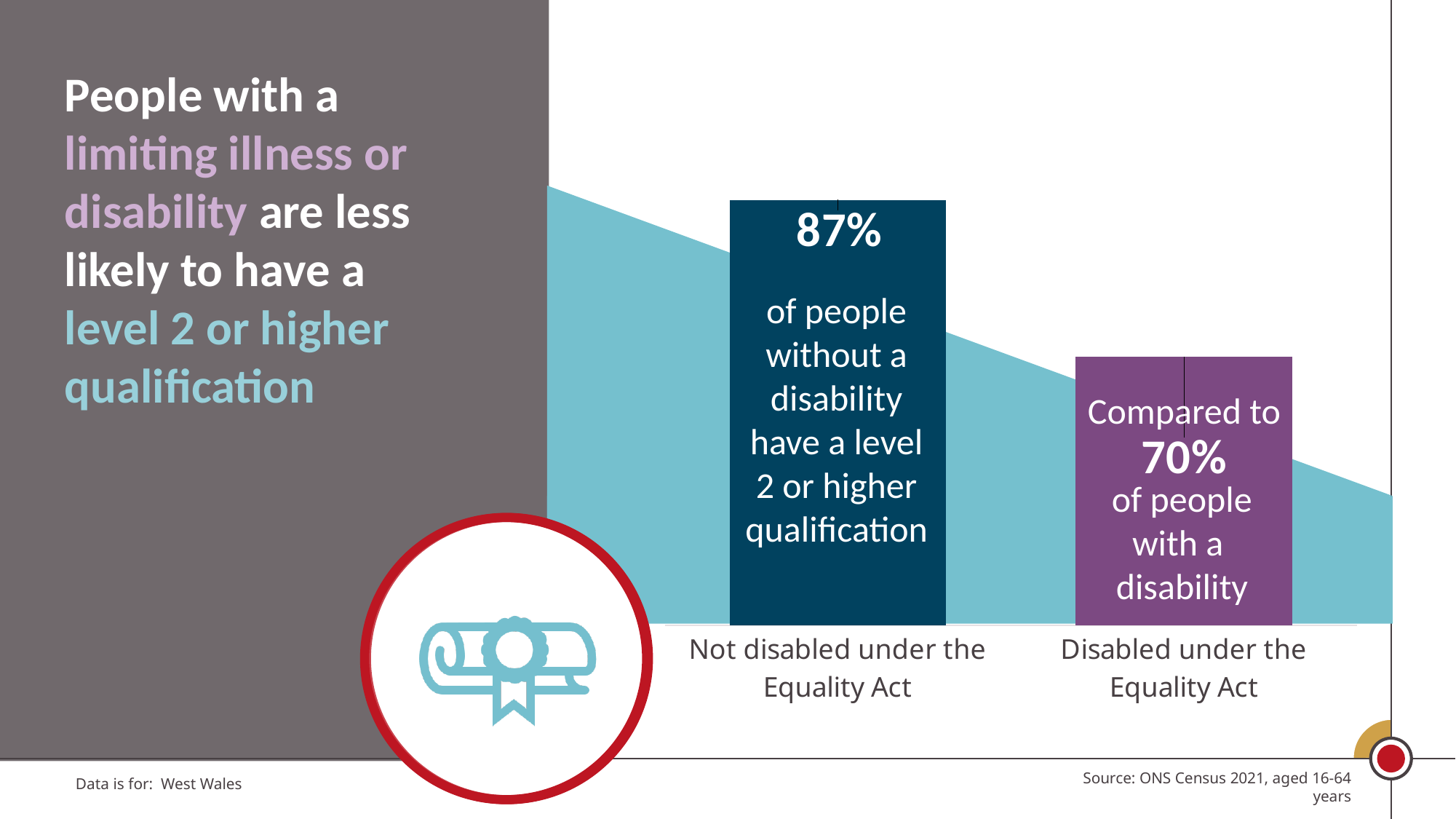
Do the values rise or fall from left to right across the chart? fall Which category has the higher value? Not disabled under the Equality Act Is the value for people not disabled under the Equality Act larger or smaller than the value for people disabled under the Equality Act? larger Which area does the data on the slide cover? West Wales What colour is the bar for people disabled under the Equality Act? purple What kind of chart is shown on the slide? bar chart Which category has the lower value? Disabled under the Equality Act What percentage of people not disabled under the Equality Act have a level 2 or higher qualification? 87% What is the difference in percentage points between the two bars? 17 percentage points What percentage of people disabled under the Equality Act have a level 2 or higher qualification? 70% How many categories are shown in the chart? 2